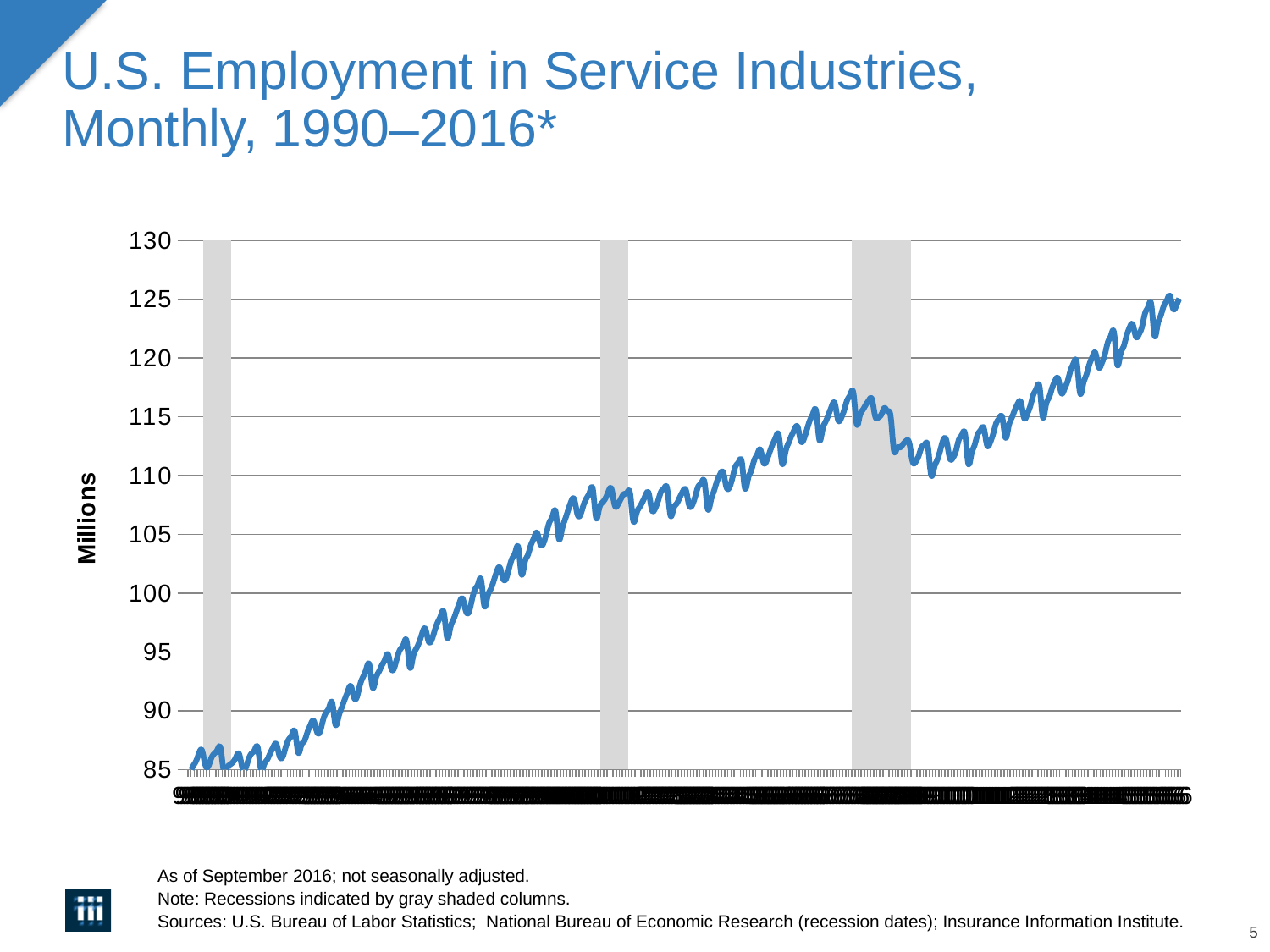
What is the highest value shown on the vertical axis of the chart? 130 Which end of the line is higher, the left end (1990) or the right end (2016)? the right end (2016) How many gray shaded recession columns are shown on the chart? 3 Is the value at the right end of the line (2016) greater or less than 120? greater What is the label on the vertical axis of the chart? Millions Does the line fall or rise during the third (rightmost) gray shaded column? fall Is the value at the left end of the line (1990) greater or less than 90? less Overall, do the values rise or fall from the left to the right of the chart? rise Is the value at the right end of the line greater or less than 130? less What is the title of the chart on the slide? U.S. Employment in Service Industries, Monthly, 1990–2016* What kind of chart is shown on the slide? line chart